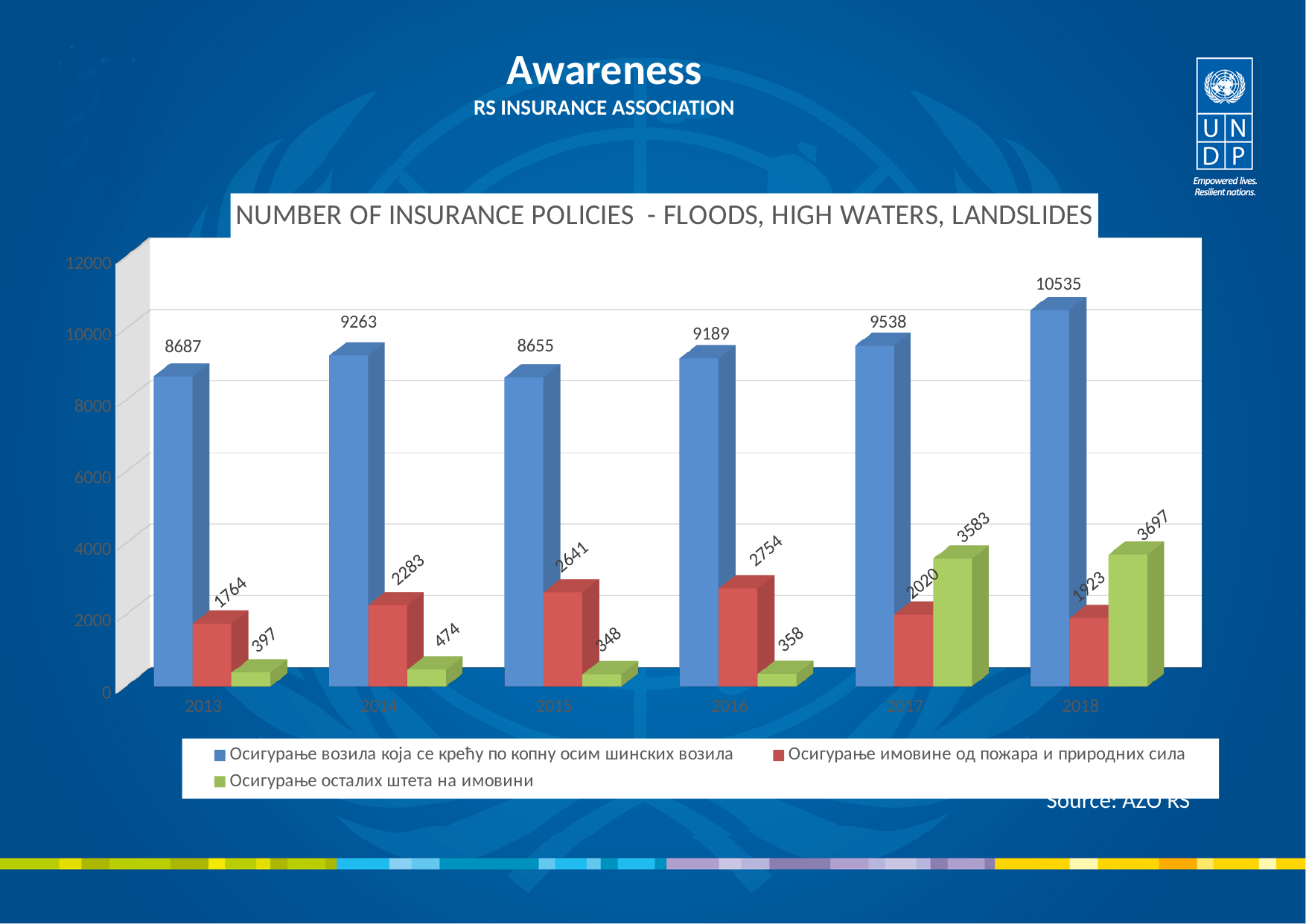
How many series does the legend list? 3 In which year is the blue series (vehicle insurance) highest? 2018 What is the value of the blue series (Осигурање возила која се крећу по копну осим шинских возила) for 2018? 10535 Which is larger: the red series value for 2015 or the red series value for 2017? 2015 (2641) In which year is the green series (Осигурање осталих штета на имовини) lowest? 2015 What is the title of the chart? NUMBER OF INSURANCE POLICIES - FLOODS, HIGH WATERS, LANDSLIDES Does the green series rise or fall from 2016 to 2017? Rise What is the value of the green series (Осигурање осталих штета на имовини) for 2014? 474 What kind of chart is shown on the slide? Bar chart What is the value of the red series (Осигурање имовине од пожара и природних сила) for 2016? 2754 What is the difference between the blue series values for 2018 and 2017? 997 How many years are shown on the x axis? 6